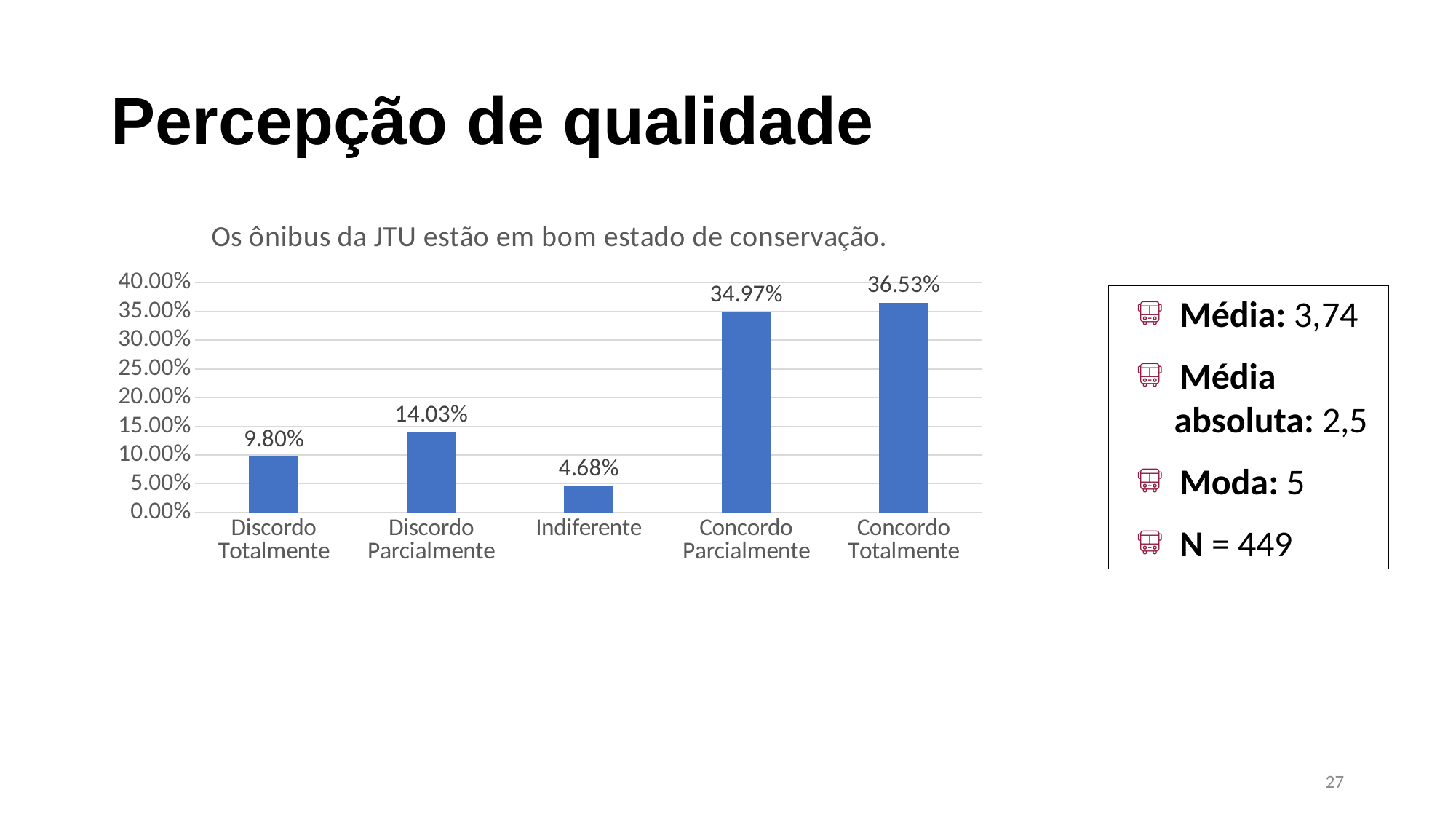
What is the value for Discordo Parcialmente? 14.03% Which is larger, Discordo Totalmente or Discordo Parcialmente? Discordo Parcialmente What is the difference between Concordo Totalmente and Concordo Parcialmente? 1.56% Which category has the lowest value? Indiferente Which category has the highest value? Concordo Totalmente What is the value for Indiferente? 4.68% How many categories are shown on the x axis? 5 Is the value for Concordo Parcialmente greater or less than 30.00%? greater What is the title of the chart? Os ônibus da JTU estão em bom estado de conservação. What kind of chart is shown on the slide? bar chart What is the value for Concordo Totalmente? 36.53% What is the difference between Discordo Parcialmente and Discordo Totalmente? 4.23%